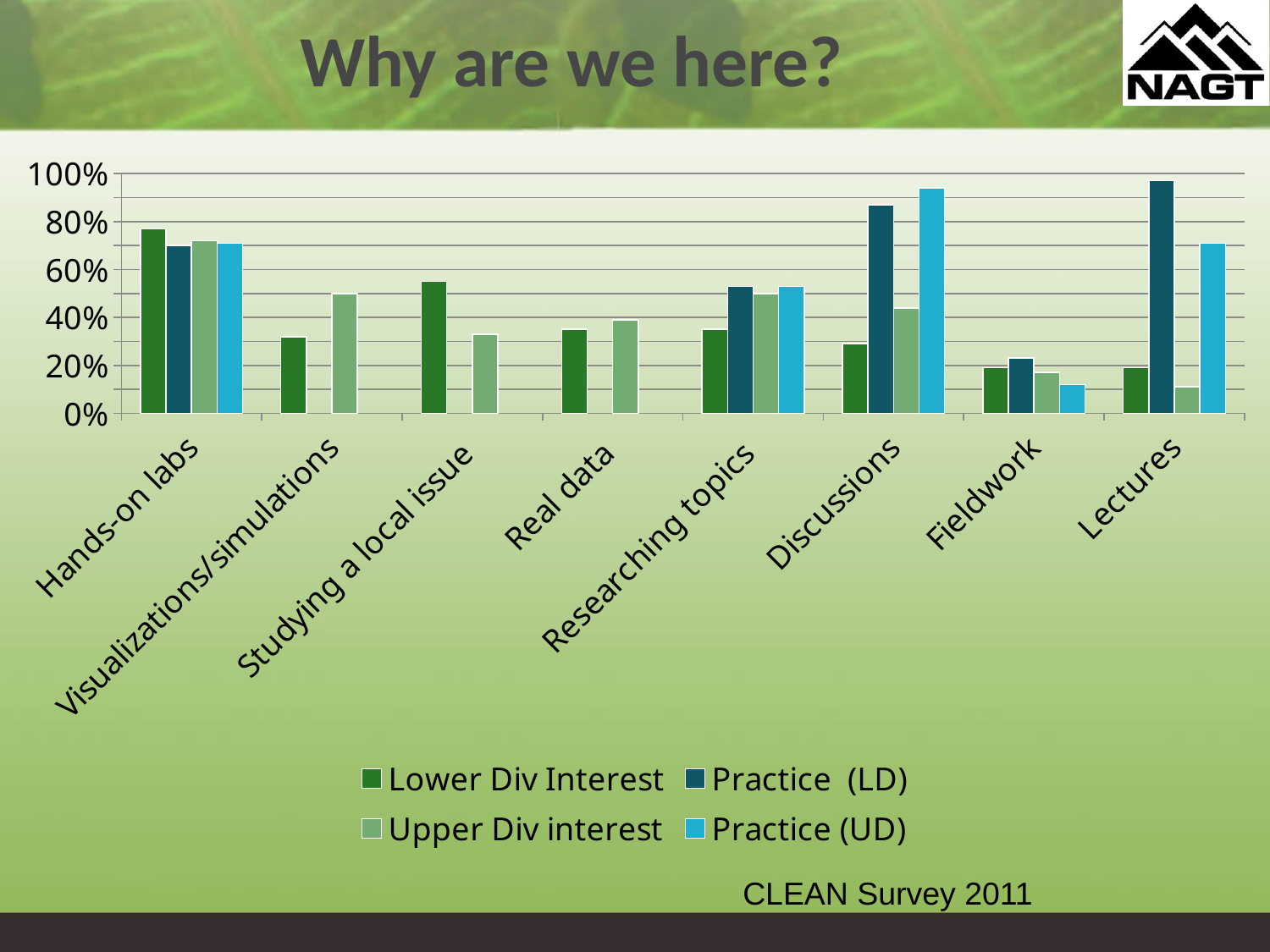
Which category has the highest Lower Div Interest value? Hands-on labs Which category has the highest Practice (UD) value? Discussions Which category has the highest Practice (LD) value? Lectures Is the Practice (LD) value for Lectures greater or less than 80%? greater For Visualizations/simulations, which is larger: Upper Div interest or Lower Div Interest? Upper Div interest Is the Lower Div Interest value for Studying a local issue greater or less than 40%? greater What kind of chart is shown on the slide? Bar chart Which category has the lowest Upper Div interest value? Lectures Is the Practice (UD) value for Fieldwork greater or less than 20%? less How many categories are shown along the x axis of the chart? 8 For Discussions, which is larger: Practice (LD) or Lower Div Interest? Practice (LD) How many series does the chart's legend list? 4